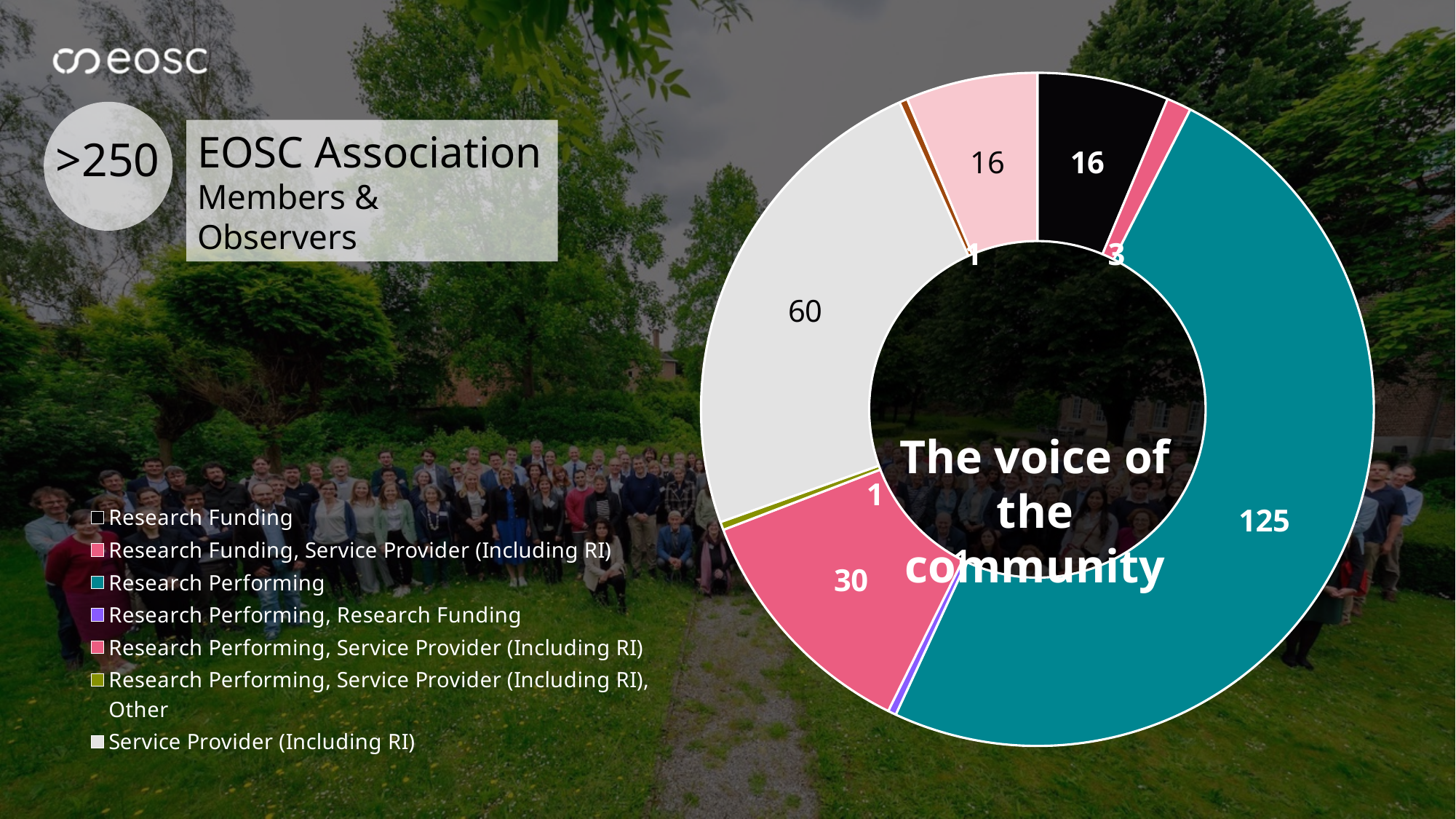
What is the value for Service Provider (Including RI) in the doughnut chart? 60 What is the value for Research Performing, Service Provider (Including RI) in the doughnut chart? 30 What is the value for Research Performing in the doughnut chart? 125 What is the difference between the Service Provider (Including RI) value and the Research Performing, Service Provider (Including RI) value? 30 Which is larger: Service Provider (Including RI) or Research Performing, Service Provider (Including RI)? Service Provider (Including RI) What is the value for Research Performing, Service Provider (Including RI), Other in the doughnut chart? 1 Which category has the largest slice in the doughnut chart? Research Performing What kind of chart is shown on the slide? Doughnut chart What text is written in the centre of the doughnut chart? The voice of the community What is the value for Research Funding, Service Provider (Including RI) in the doughnut chart? 3 What is the difference between the Research Performing value and the Service Provider (Including RI) value? 65 How many entries does the legend of the doughnut chart list? 7